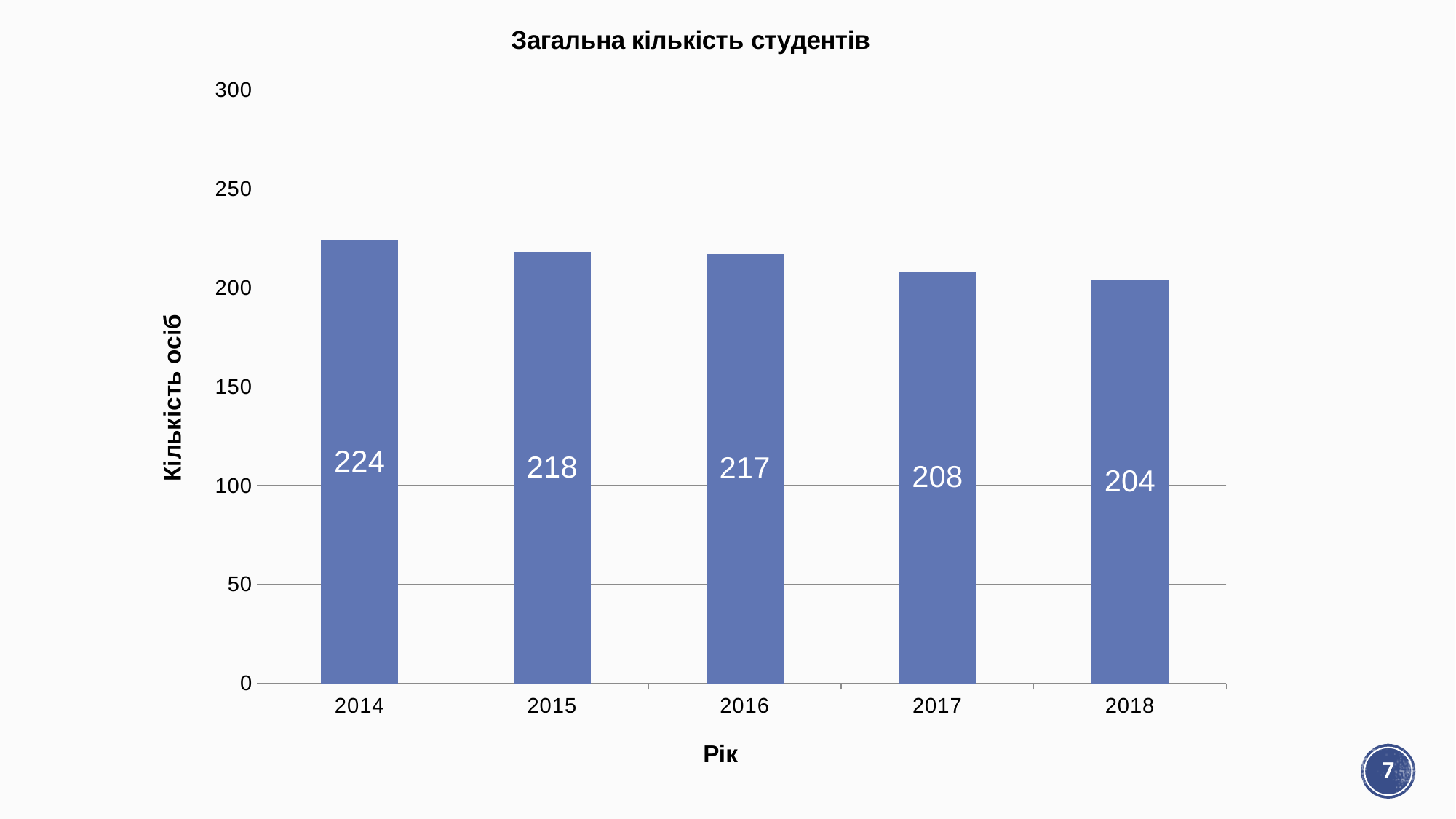
What is the difference between the number of students in 2014 and 2018? 20 What kind of chart is this? bar chart Do the values rise or fall from 2014 to 2018? fall Which year has the highest number of students? 2014 What is the total number of students in 2014? 224 What is the difference between the values for 2016 and 2017? 9 Which year has the lowest number of students? 2018 Which year has more students, 2015 or 2017? 2015 What is the total number of students in 2018? 204 Is the value for 2017 greater or less than 250? less What is the value shown for 2016? 217 How many years are shown on the x axis? 5